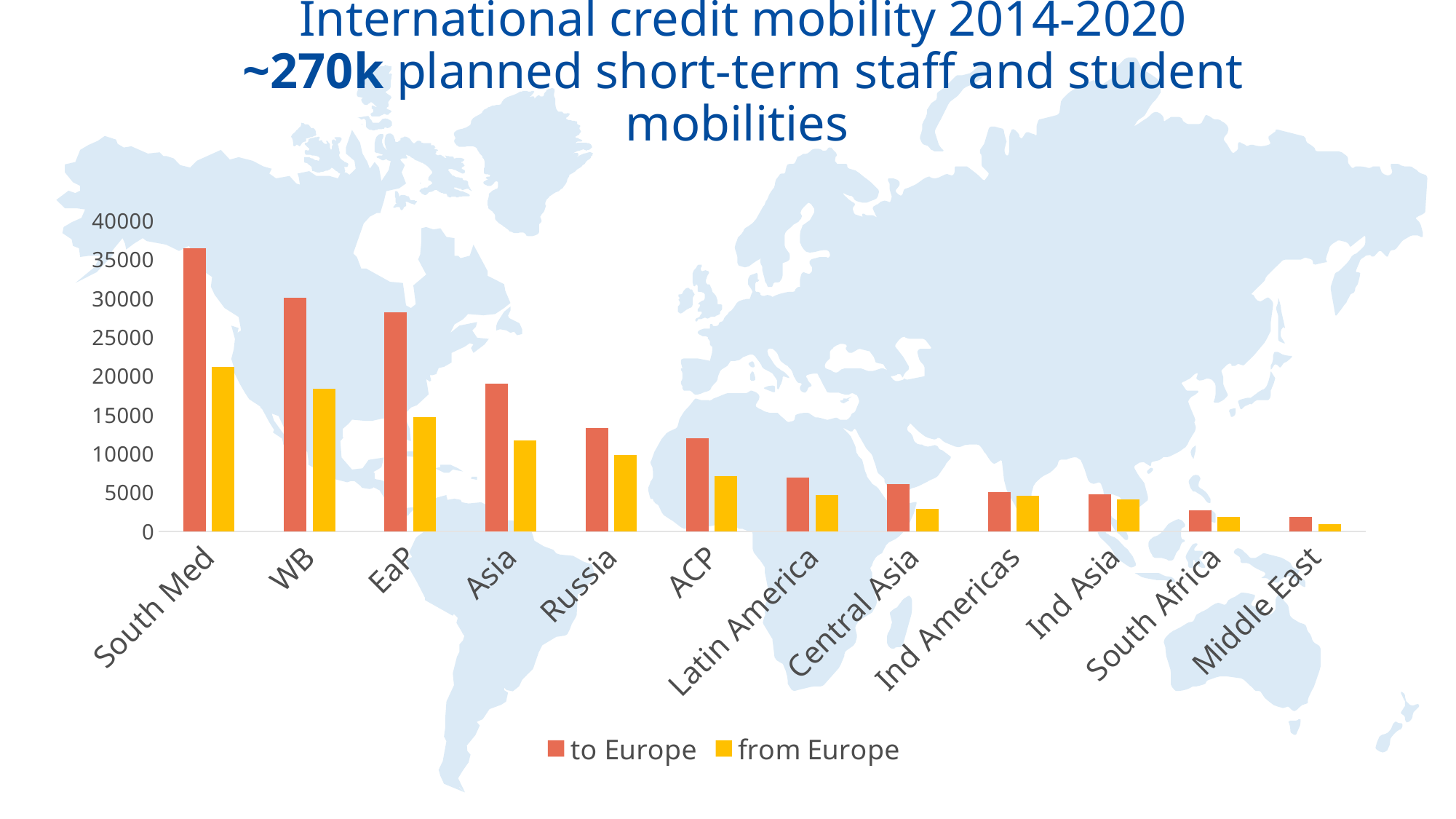
How many series does the legend list? 2 Is the 'to Europe' value for South Med greater or less than 35000? greater Is the 'to Europe' value for EaP greater or less than 30000? less Is the 'from Europe' value for ACP greater or less than 5000? greater What kind of chart is shown on the slide? bar chart Which region has the lowest 'from Europe' value? Middle East Which is larger: the 'to Europe' value for Asia or the 'to Europe' value for Russia? Asia How many regions are shown on the x axis? 12 Which colour represents the 'from Europe' series? yellow Which region has the highest 'to Europe' value? South Med Do the 'to Europe' values rise or fall moving from left to right along the x axis? fall